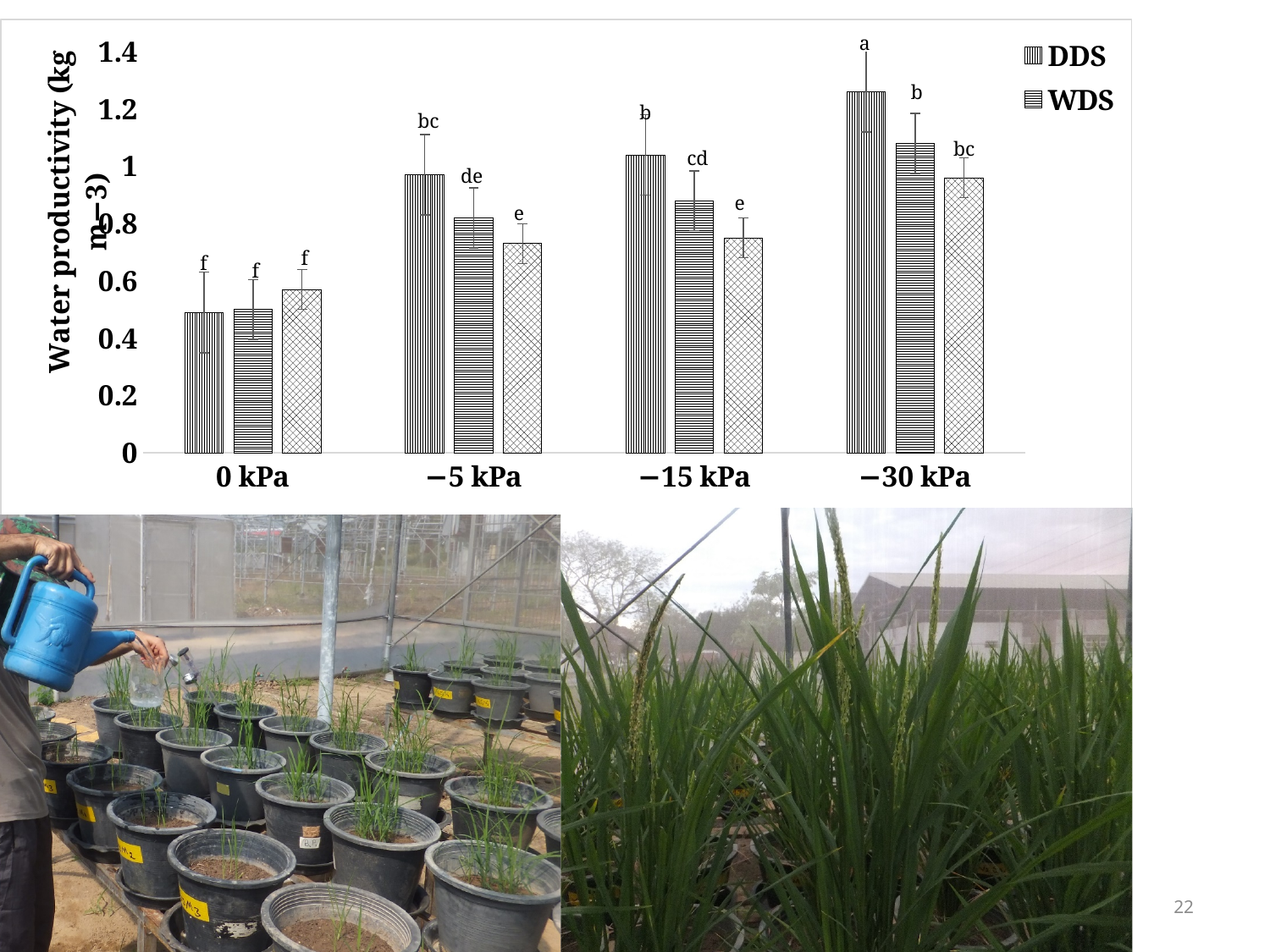
At −30 kPa, which is larger, the DDS bar or the WDS bar? DDS Do the DDS values rise or fall from 0 kPa to −30 kPa along the x axis? rise Is the value for WDS at −15 kPa greater or less than 0.8? greater What is the label of the y axis of the chart? Water productivity (kg m−3) At which category is the DDS bar highest? −30 kPa How many series does the chart's legend list? 2 How many categories are shown on the x axis of the chart? 4 Is the value for DDS at 0 kPa greater or less than 0.8? less What kind of chart is shown on the slide? bar chart Is the value for DDS at −30 kPa greater or less than 1? greater Which series are listed in the chart's legend? DDS and WDS At which category is the DDS bar lowest? 0 kPa